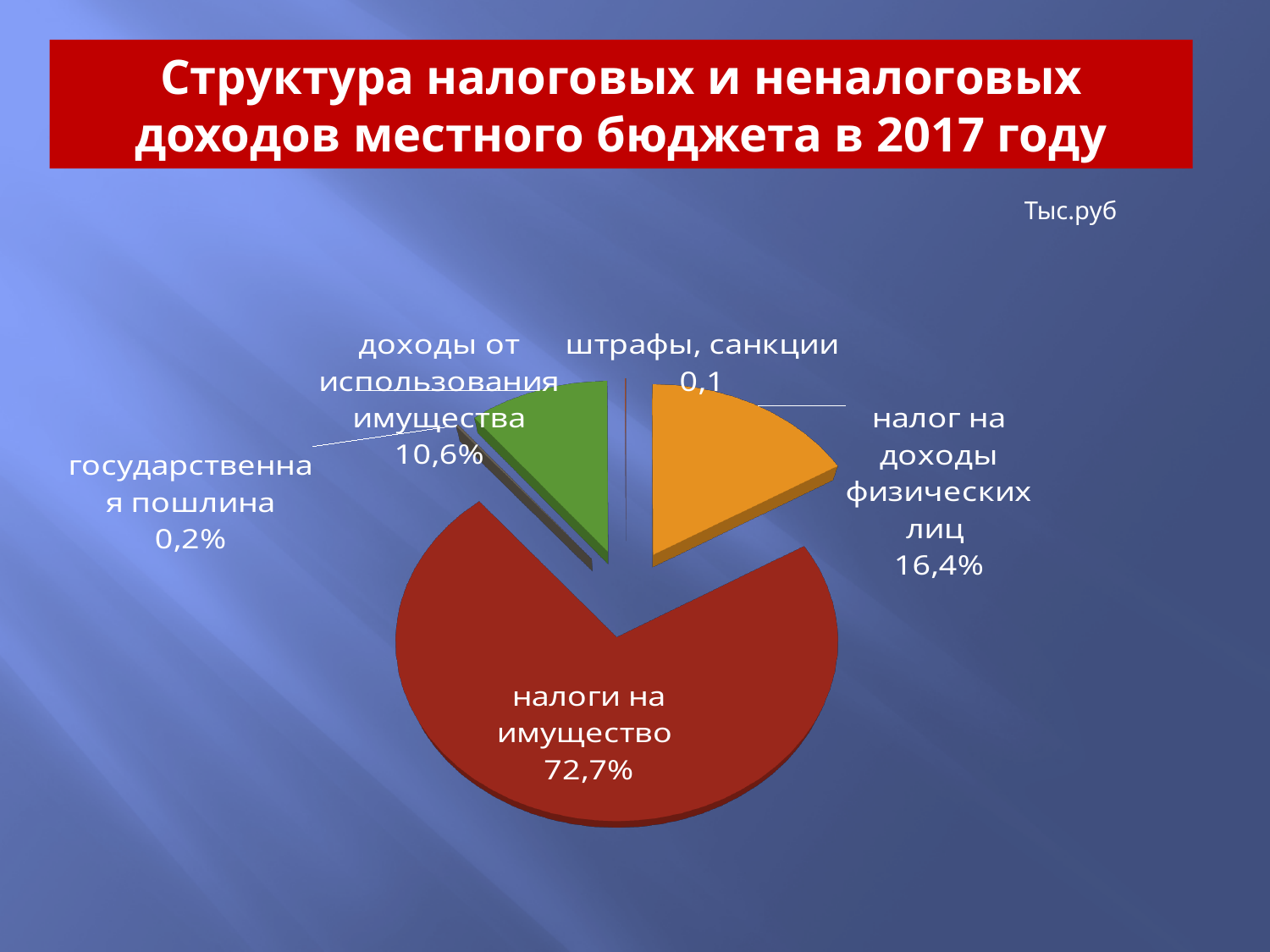
What value is printed for штрафы, санкции? 0,1 Which category has the smallest slice of the pie? штрафы, санкции How many categories are shown in the pie chart? 5 What value is shown for государственная пошлина? 0,2% What is the title of the chart on the slide? Структура налоговых и неналоговых доходов местного бюджета в 2017 году What value is shown for налог на доходы физических лиц? 16,4% What share of the pie does налоги на имущество account for? 72,7% What is the difference in percentage points between налоги на имущество and налог на доходы физических лиц? 56,3 What value is shown for доходы от использования имущества? 10,6% Which category has the largest slice of the pie? налоги на имущество What kind of chart is shown on the slide? pie chart Which is larger: налог на доходы физических лиц or доходы от использования имущества? налог на доходы физических лиц